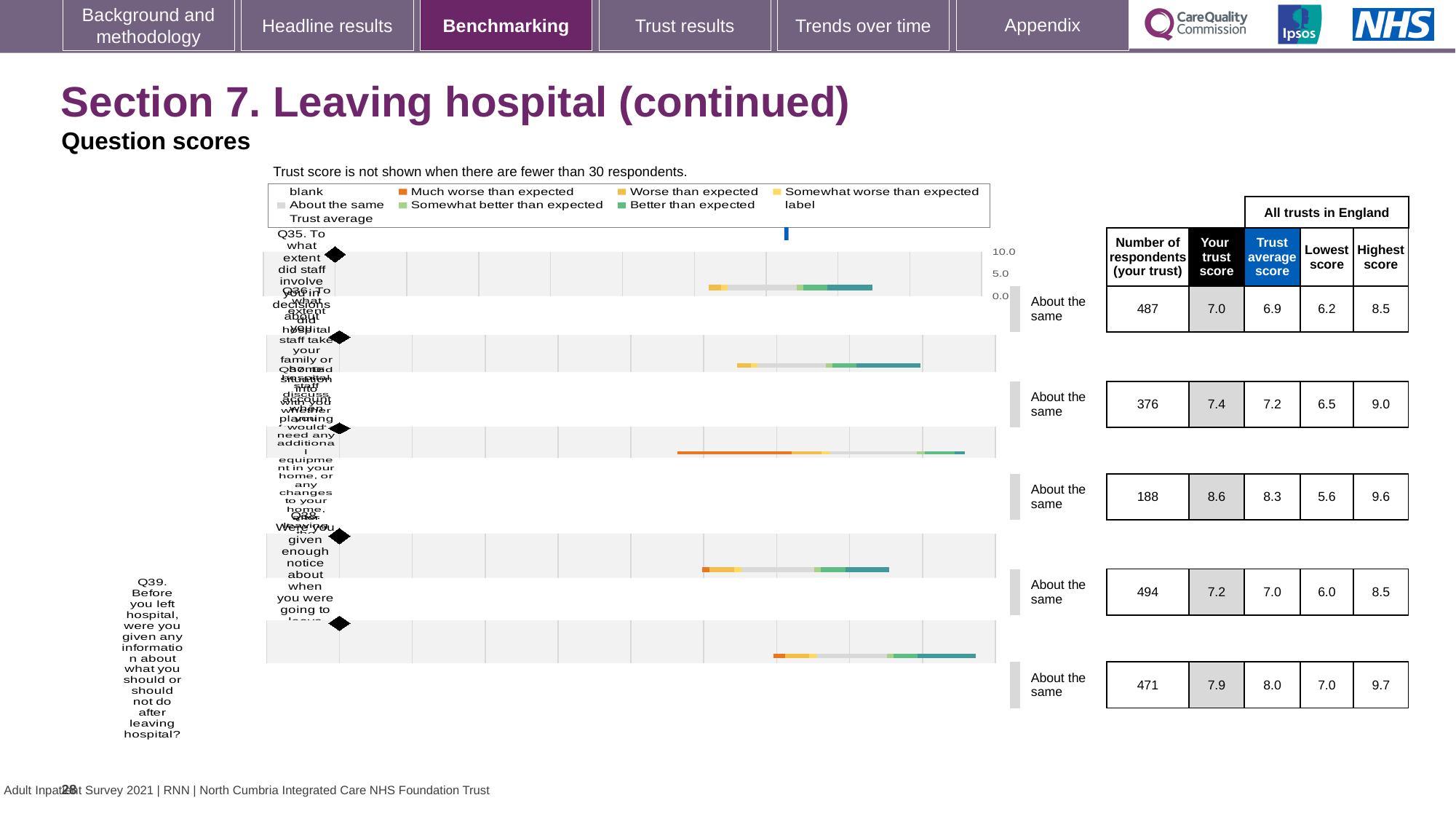
What is the highest score across all trusts in England for Q39? 9.7 What is the largest 'Your trust score' value shown in the table? 8.6 For Q39, is the trust's own score higher or lower than the trust average score? lower What is the trust average score for Q39 in the table? 8.0 What is the smallest number of respondents shown in the table? 188 What is the 'Your trust score' value for Q39 in the table? 7.9 How many respondents are shown for the first question row (Q35) in the table? 487 How many question rows are shown in the benchmarking chart and table? 5 What type of chart is used to show the question scores on this slide? bar chart What heading appears above the 'Trust average score', 'Lowest score' and 'Highest score' columns in the table? All trusts in England In the table, how many respondents are shown for Q39 (Before you left hospital, were you given any information about what you should or should not do after leaving hospital?)? 471 For Q39, what is the difference between the highest score and the lowest score across all trusts in England? 2.7